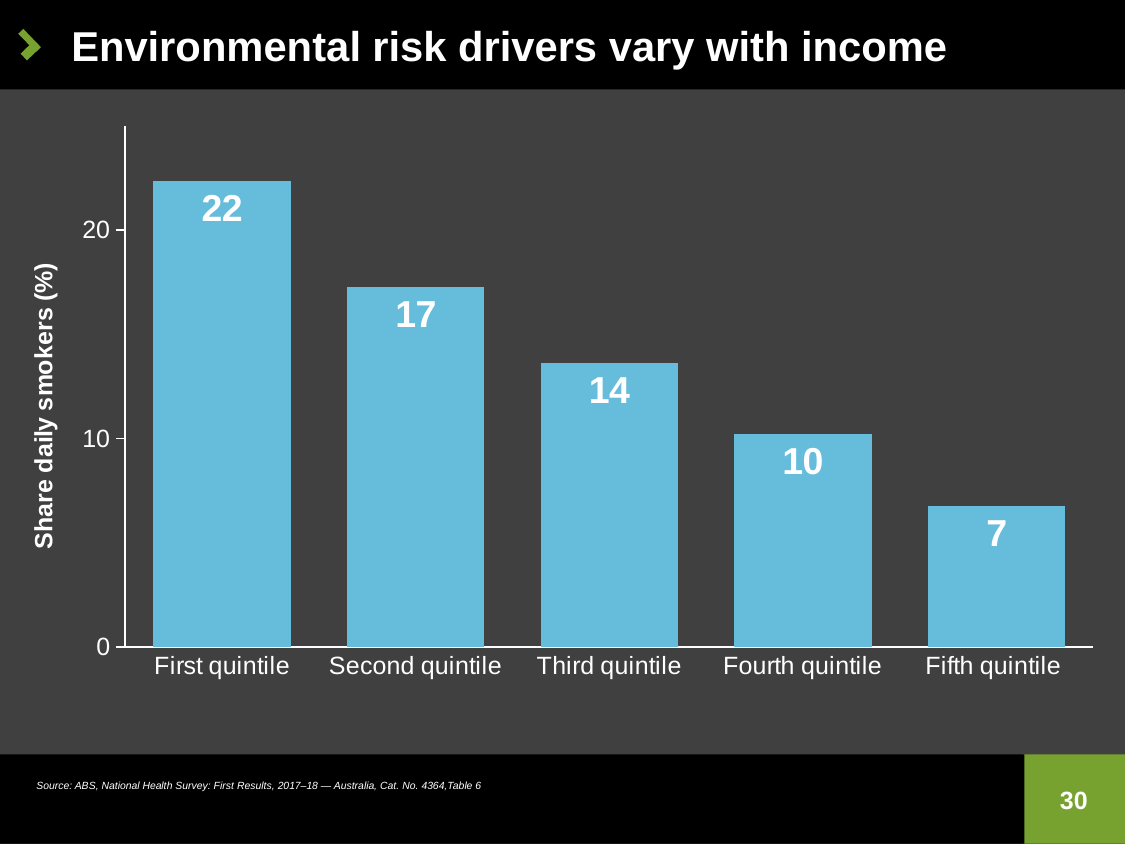
Is the value for the Third quintile greater or less than 10? greater Which quintile has the lowest share of daily smokers? Fifth quintile What is the share of daily smokers for the Third quintile? 14 Which quintile has the highest share of daily smokers? First quintile What is the difference in share of daily smokers between the First quintile and the Fifth quintile? 15 What is the difference in share of daily smokers between the Second quintile and the Fourth quintile? 7 How many quintiles are shown on the chart? 5 What is the share of daily smokers for the First quintile? 22 What kind of chart is shown on the slide? Bar chart Do the values rise or fall from the First quintile to the Fifth quintile? Fall Which has a larger share of daily smokers, the Second quintile or the Fourth quintile? Second quintile What is the share of daily smokers for the Fifth quintile? 7